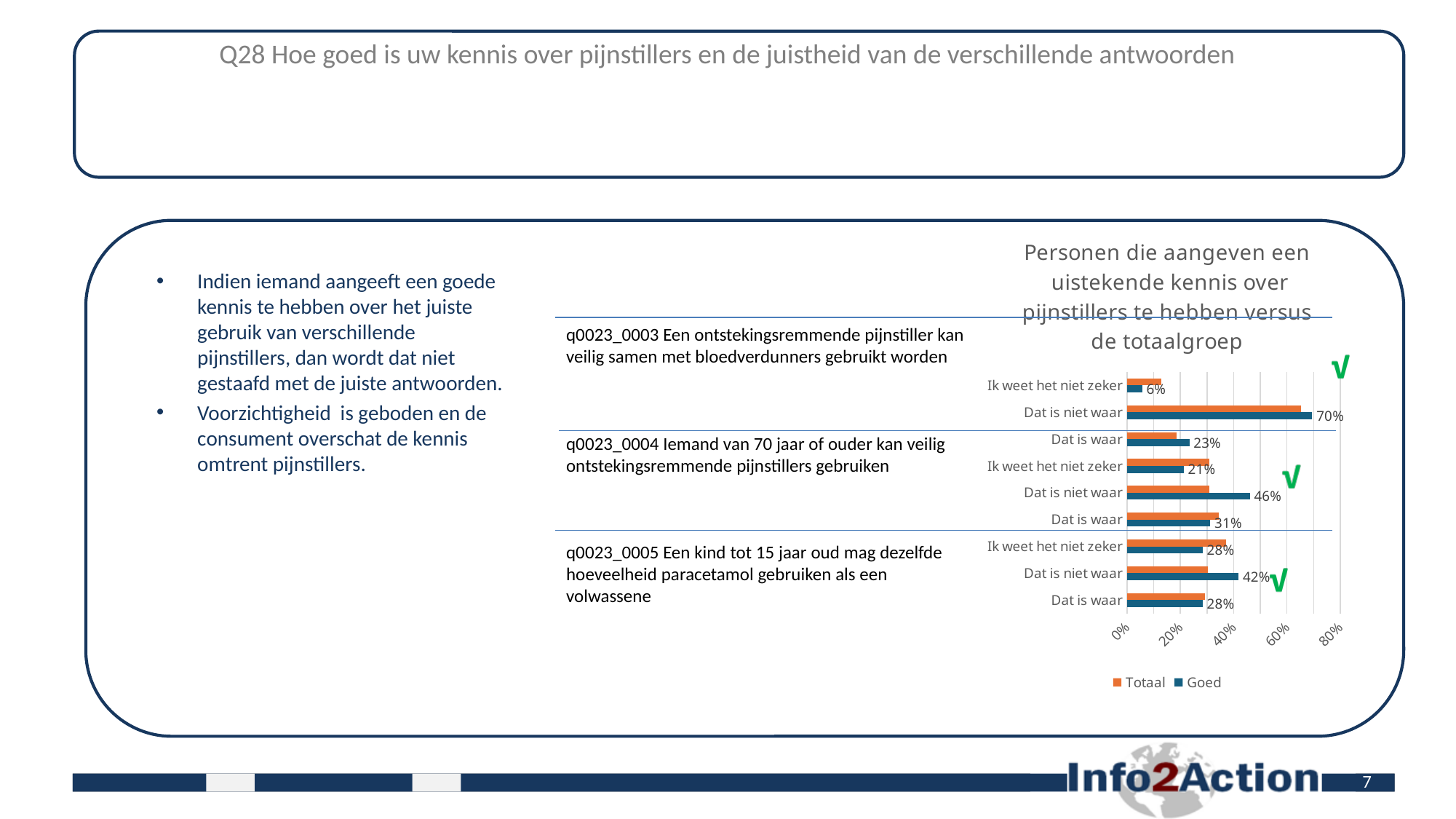
What is the Goed value for the topmost 'Dat is niet waar' category? 70% What is the Goed value for the bottommost 'Dat is niet waar' category? 42% What is the Goed value for the topmost 'Ik weet het niet zeker' category? 6% How many series does the chart legend list? 2 What kind of chart is shown on the slide? bar chart How many category rows are plotted in the chart? 9 What are the two series named in the chart legend? Totaal and Goed Which category has the highest Goed value in the chart? Dat is niet waar (topmost, 70%) What is the difference between the highest Goed value (70%) and the lowest Goed value (6%)? 64 percentage points What is the Goed value for the second 'Dat is niet waar' category from the top? 46% Is the Totaal value for the topmost 'Dat is niet waar' category greater or less than 60%? greater Which category has the lowest Goed value in the chart? Ik weet het niet zeker (topmost, 6%)